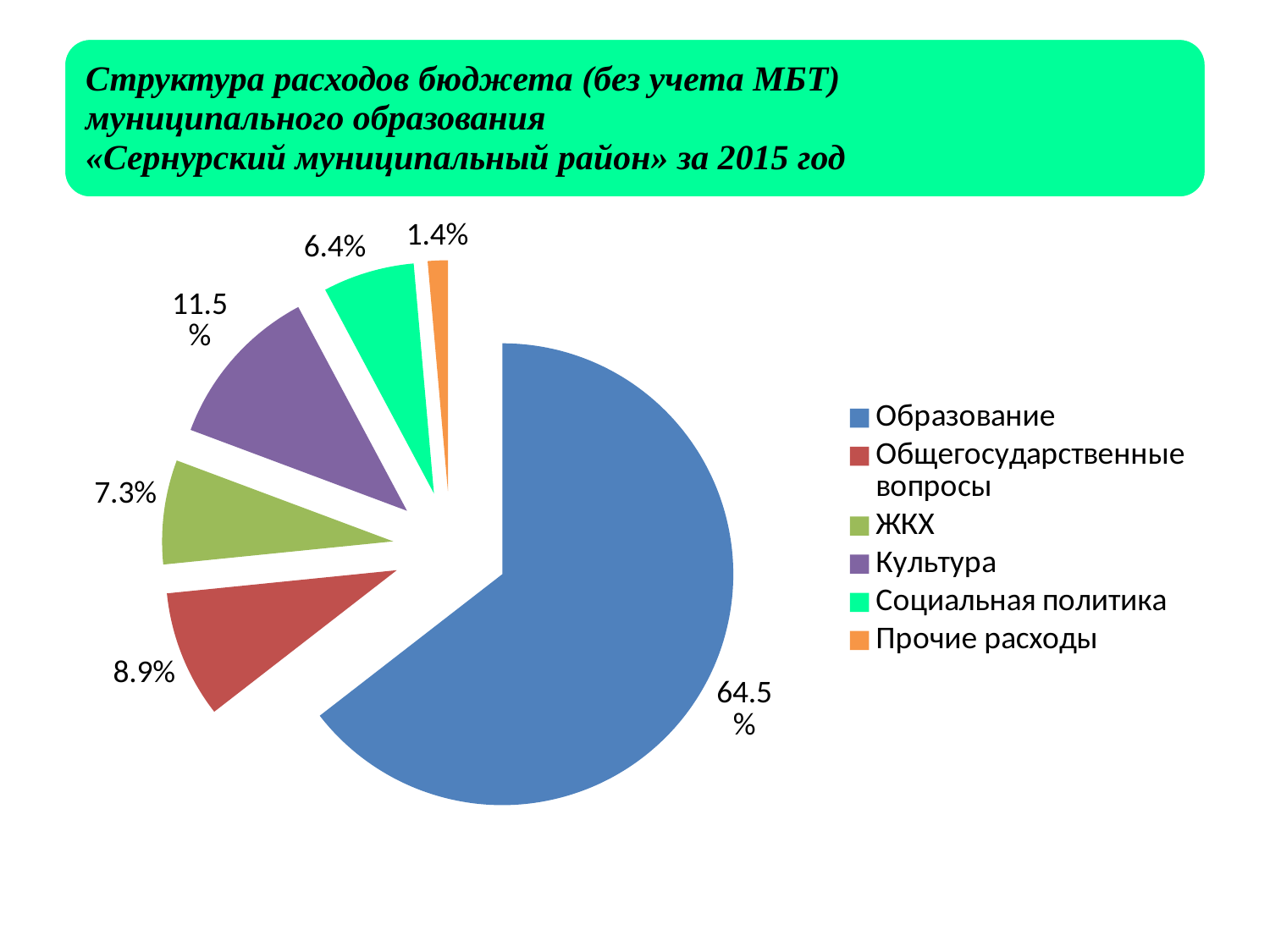
What share of the pie does Образование have? 64.5% Which category has the smallest slice of the pie? Прочие расходы What is the value shown for Культура? 11.5% What is the value shown for Прочие расходы? 1.4% Which category has the largest slice of the pie? Образование What is the difference between the shares of Культура and ЖКХ? 4.2% Which is larger, the share for Общегосударственные вопросы or the share for Социальная политика? Общегосударственные вопросы What is the value shown for Общегосударственные вопросы? 8.9% What is the combined share of ЖКХ and Социальная политика? 13.7% How many slices does the pie chart have? 6 Which colour represents Социальная политика in the legend? Bright green What kind of chart is shown on the slide? Pie chart